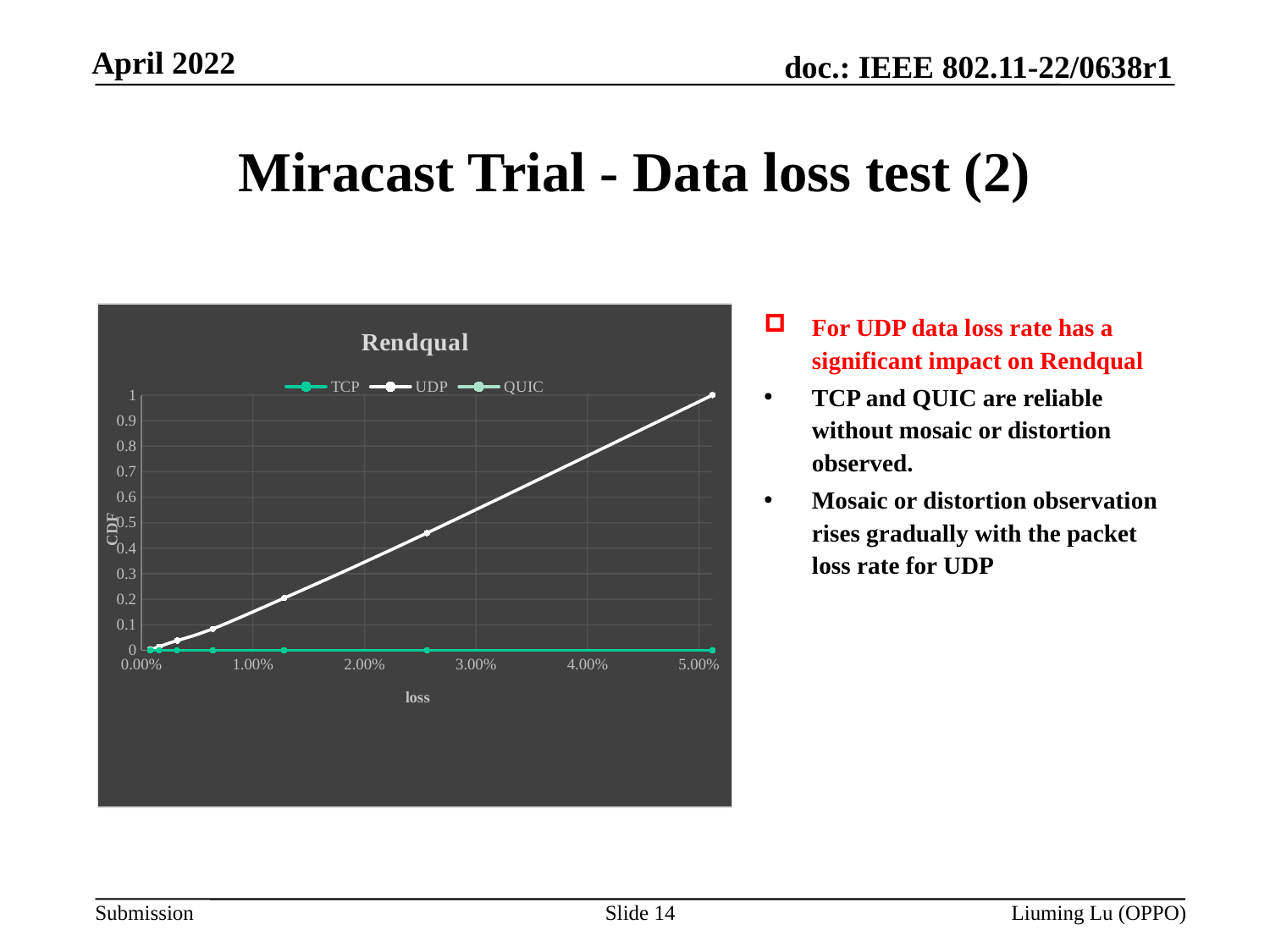
What is the highest CDF value reached by the UDP series? 1 What type of chart is shown on the slide? line chart Is the UDP CDF value at 4.00% loss greater or less than 0.5? greater What is the title of the chart? Rendqual What is the label of the x axis? loss How many series does the chart legend list? 3 Which series reaches the highest CDF value on the chart? UDP Is the UDP CDF value at 1.00% loss greater or less than 0.5? less At 3.00% loss, which series has the larger CDF value, UDP or QUIC? UDP What CDF value does the TCP series stay at across all loss values? 0 Which series are listed in the chart legend? TCP, UDP, QUIC Does the UDP series rise or fall as loss increases along the x axis? rise